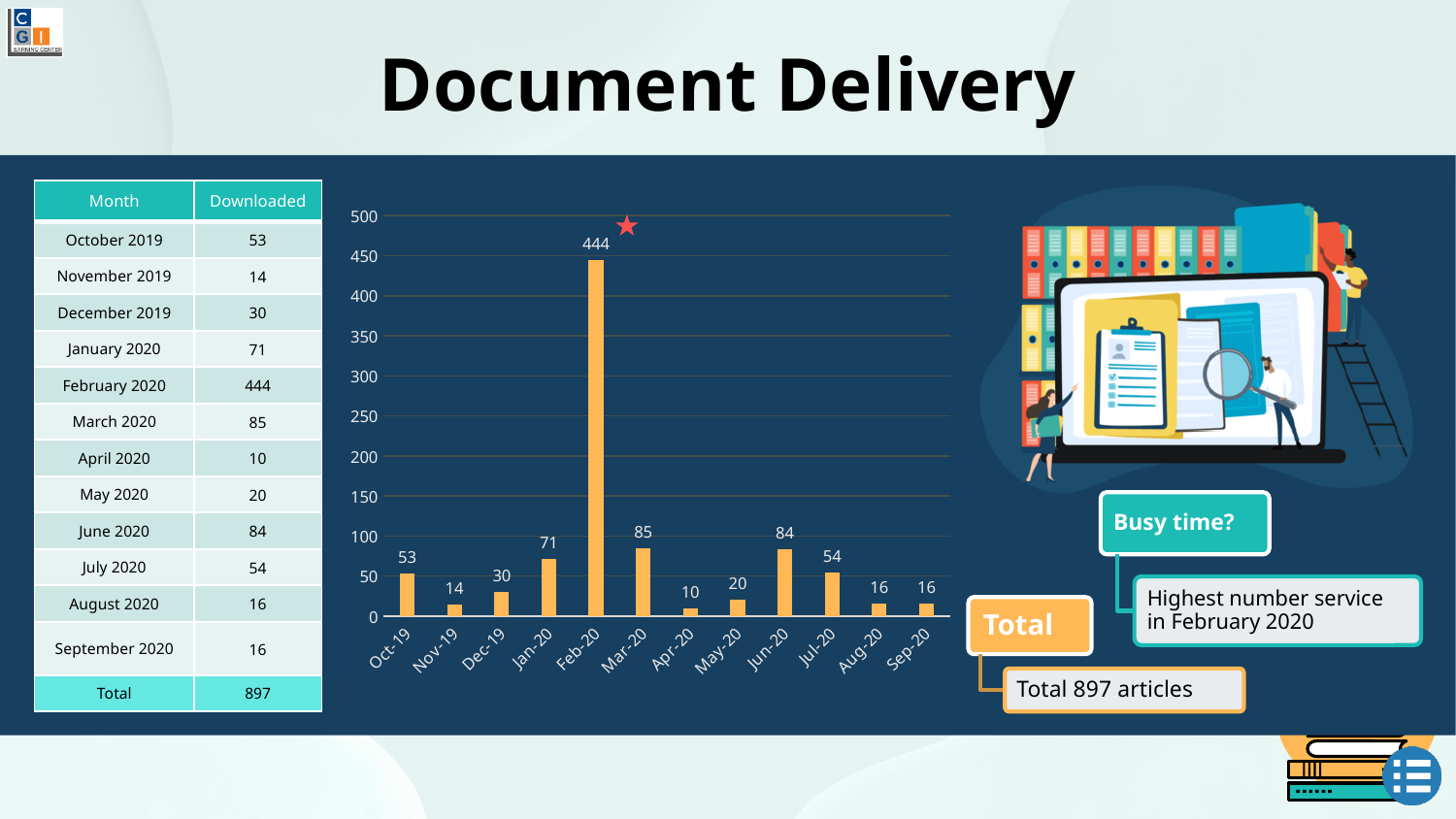
What is the value for Jun-20 in the chart? 84 Which is larger, the value for Jan-20 or the value for Jul-20? Jan-20 What is the highest value shown on the y axis of the chart? 500 How many months are shown on the x axis of the chart? 12 Which month has the lowest value in the chart? Apr-20 What is the difference between the values for Dec-19 and Nov-19? 16 What is the value for Feb-20 in the chart? 444 What kind of chart is shown on the slide? bar chart What is the difference between the values for Feb-20 and Mar-20? 359 Is the value for Feb-20 greater or less than 400? greater Which month has the highest value in the chart? Feb-20 What is the value for Oct-19 in the chart? 53